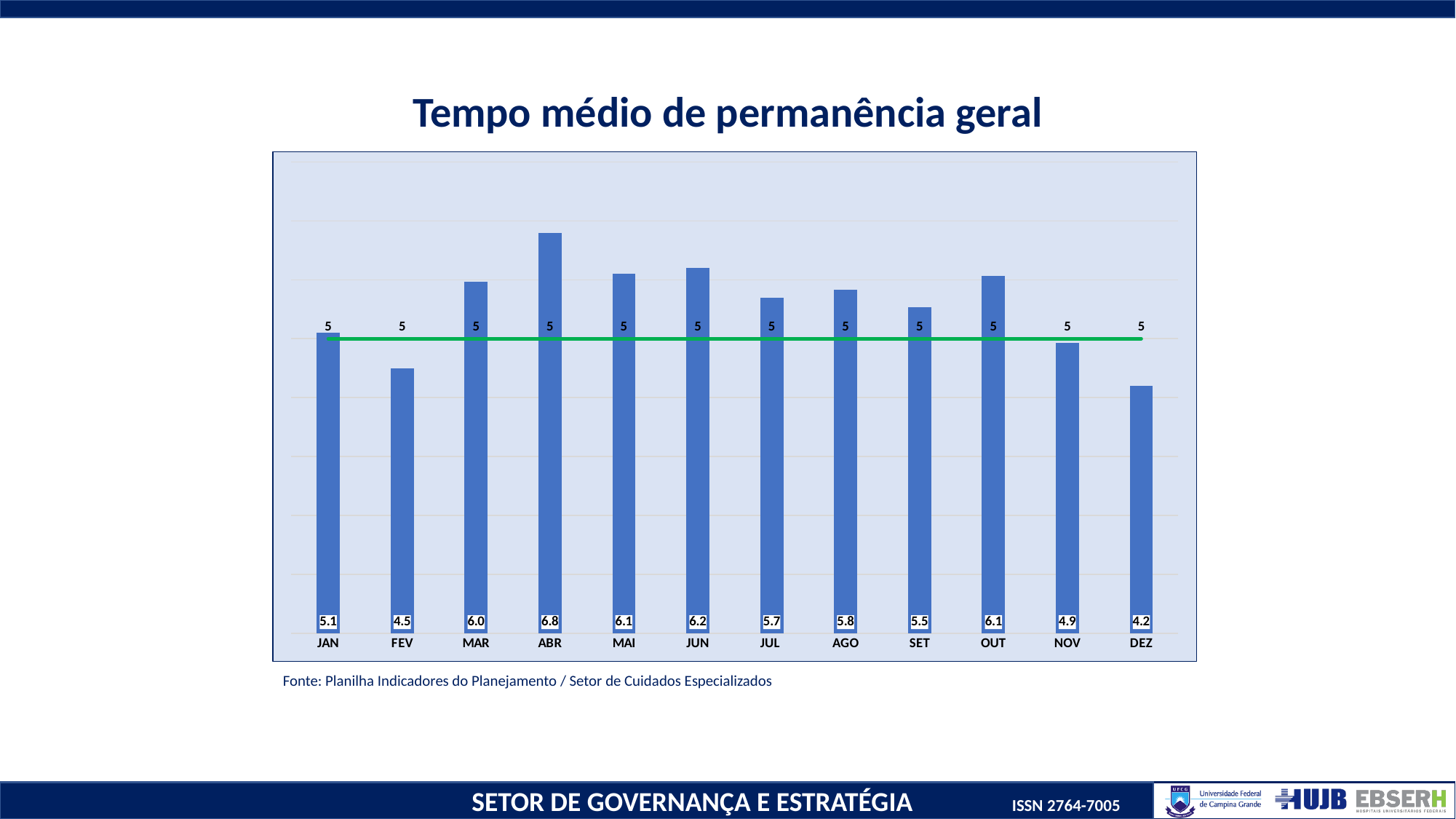
Do the values rise or fall from OUT to DEZ? fall What is the value for ABR? 6.8 What is the value of the green target line for each month? 5 Which month has the lowest value? DEZ What kind of chart is this? combination bar and line chart What is the title of the chart? Tempo médio de permanência geral How many months are shown on the x axis? 12 What is the value for JUN? 6.2 Which is larger, the value for MAR or the value for JUL? MAR What is the value for DEZ? 4.2 What is the difference between the values for ABR and FEV? 2.3 Which month has the highest value? ABR